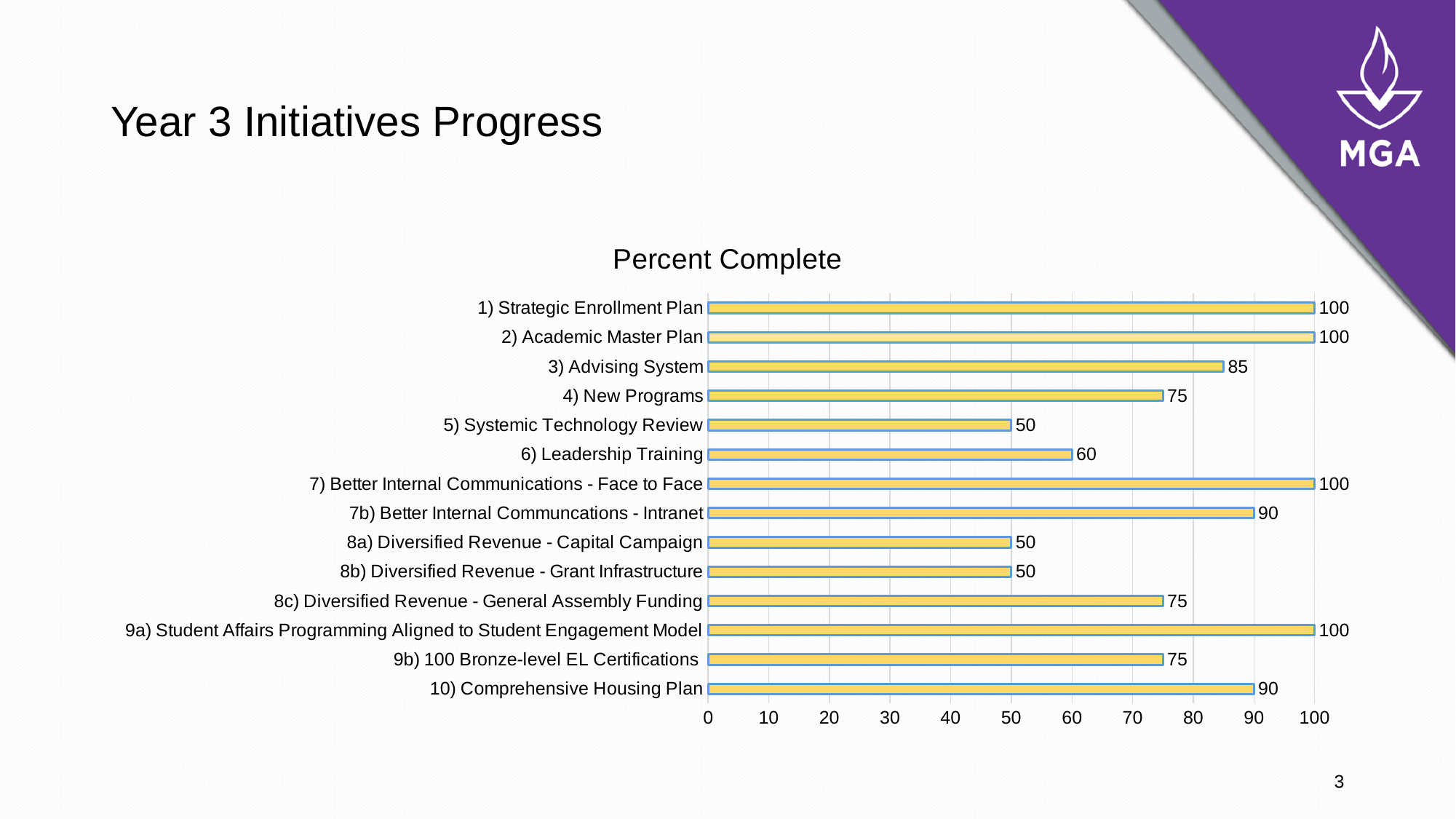
What is the value for 6) Leadership Training? 60 What is the value for 10) Comprehensive Housing Plan? 90 What kind of chart is shown on the slide? Bar chart What is the value for 3) Advising System? 85 How many categories have a value of 100? 4 What is the difference between the values for 1) Strategic Enrollment Plan and 6) Leadership Training? 40 What is the value for 8c) Diversified Revenue - General Assembly Funding? 75 Which is larger, the value for 3) Advising System or the value for 4) New Programs? 3) Advising System How many categories are shown in the chart? 14 What is the title of the chart? Percent Complete Which category has the lowest value among 4) New Programs, 5) Systemic Technology Review and 6) Leadership Training? 5) Systemic Technology Review What is the difference between the values for 7b) Better Internal Communcations - Intranet and 8a) Diversified Revenue - Capital Campaign? 40